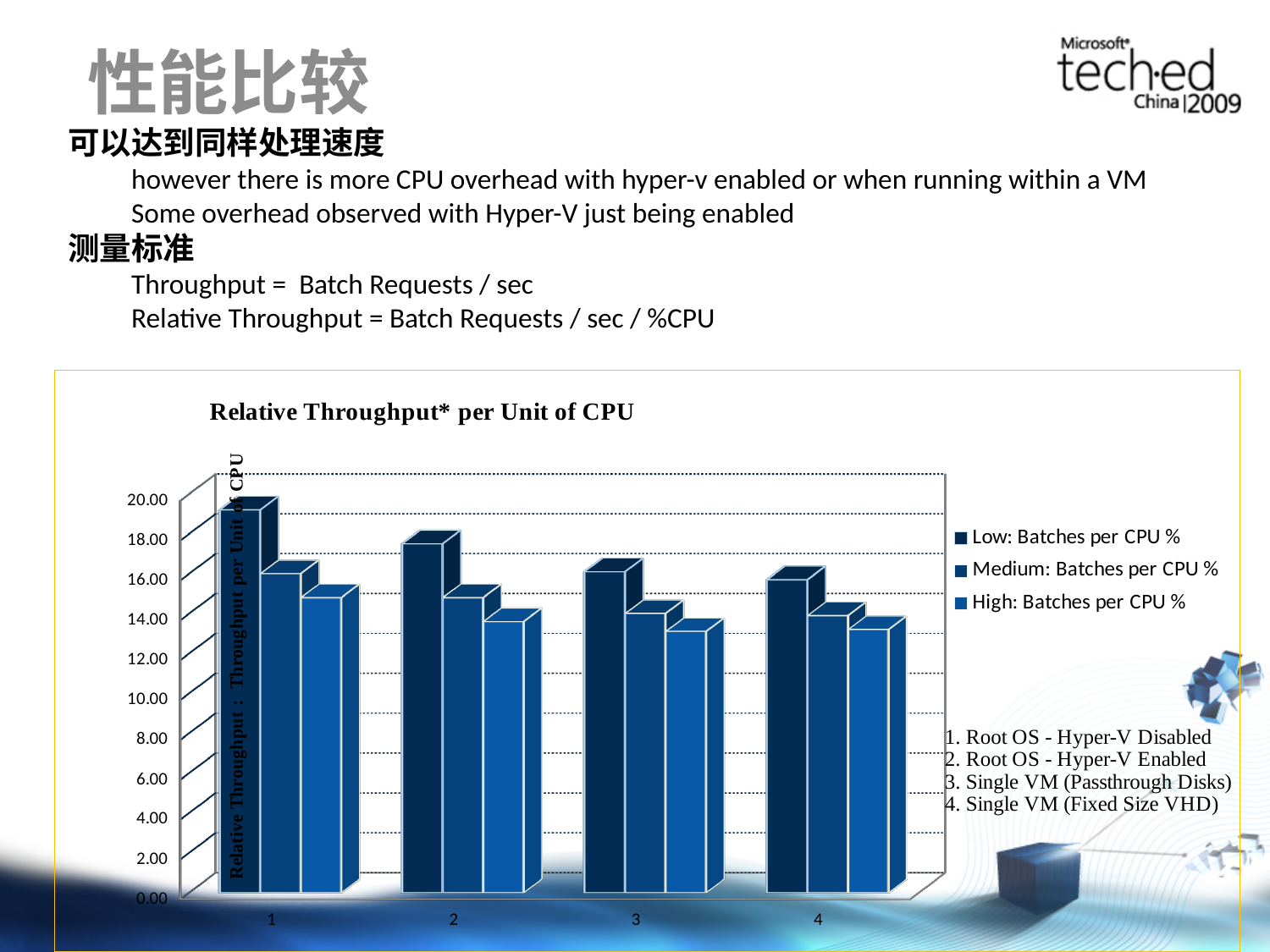
Which category has the highest value for the Low: Batches per CPU % series? 1 According to the note on the chart, what does category 3 represent? Single VM (Passthrough Disks) What kind of chart is shown on the slide? bar chart What is the title of the chart? Relative Throughput* per Unit of CPU Is the value for Low: Batches per CPU % in category 1 greater or less than 18.00? greater Is the value for Medium: Batches per CPU % in category 1 greater or less than 14.00? greater Do the values of the Low: Batches per CPU % series rise or fall from category 1 to category 4? fall Is the value for High: Batches per CPU % in category 2 greater or less than 16.00? less How many categories are shown along the x axis of the chart? 4 Which series has the lowest value in category 1? High: Batches per CPU % In category 1, which is larger: the Low: Batches per CPU % value or the High: Batches per CPU % value? Low: Batches per CPU % How many series does the legend list in the chart? 3